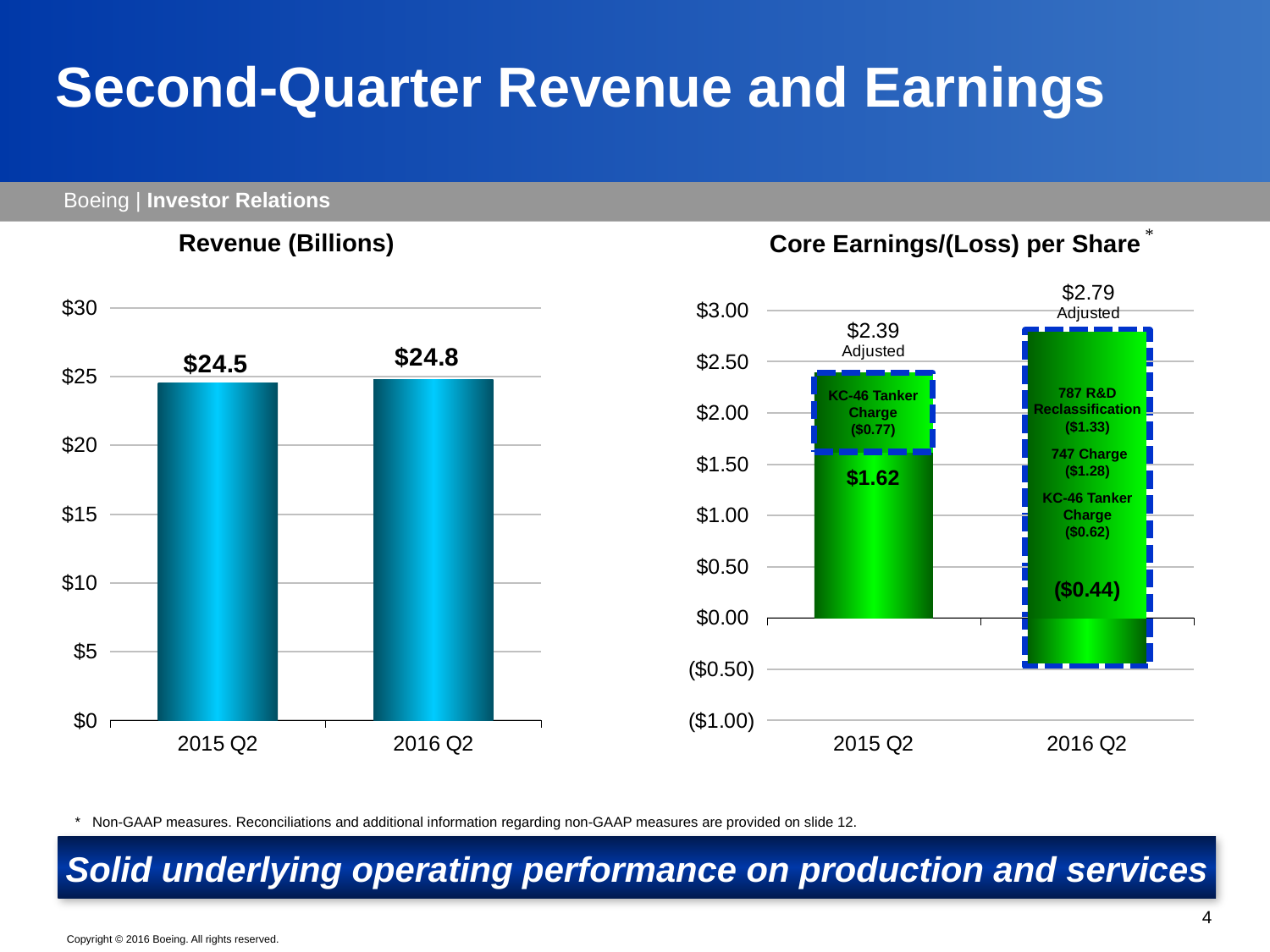
In the Revenue (Billions) chart, what is the revenue for 2015 Q2? $24.5 In the Core Earnings/(Loss) per Share chart, what is the size of the 747 Charge shown for 2016 Q2? ($1.28) What kind of chart is the Revenue (Billions) chart? Bar chart In the Core Earnings/(Loss) per Share chart, what is the adjusted core earnings per share for 2015 Q2? $2.39 In the Core Earnings/(Loss) per Share chart, what is the adjusted core earnings per share for 2016 Q2? $2.79 In the Core Earnings/(Loss) per Share chart, what is the size of the KC-46 Tanker Charge shown for 2015 Q2? ($0.77) In the Revenue (Billions) chart, what is the difference between the 2016 Q2 and 2015 Q2 revenue? $0.3 In the Revenue (Billions) chart, what is the revenue for 2016 Q2? $24.8 In the Core Earnings/(Loss) per Share chart, what is the reported core earnings per share for 2015 Q2? $1.62 In the Revenue (Billions) chart, how many quarters are plotted? 2 In the Revenue (Billions) chart, which quarter has the higher revenue? 2016 Q2 In the Core Earnings/(Loss) per Share chart, what is the reported core earnings/(loss) per share for 2016 Q2? ($0.44)